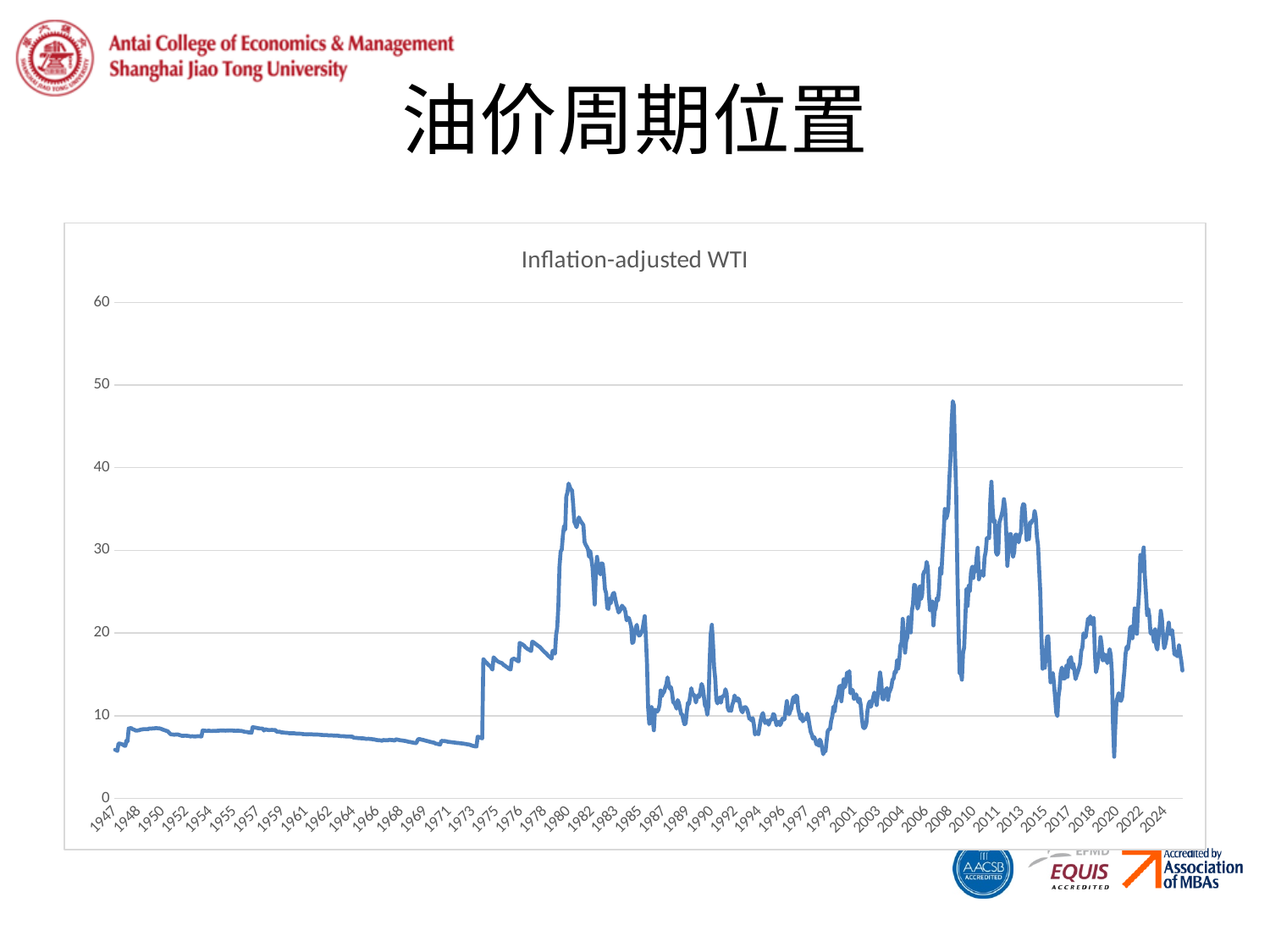
What is the title of the chart? Inflation-adjusted WTI Between 2003 and 2008, does the line generally rise or fall? rise Is the value of the line around 1998 greater or less than 10? less Which peak is higher, the one around 1980 or the one around 2008? 2008 In which year does the Inflation-adjusted WTI line reach its highest point? 2008 Between 1980 and 1986, does the line generally rise or fall? fall Is the lowest value of the line around 2020 greater or less than 10? less What kind of chart is shown on the slide? line chart What is the highest value shown on the vertical axis of the chart? 60 Is the peak value of the line around 1980 greater or less than 30? greater